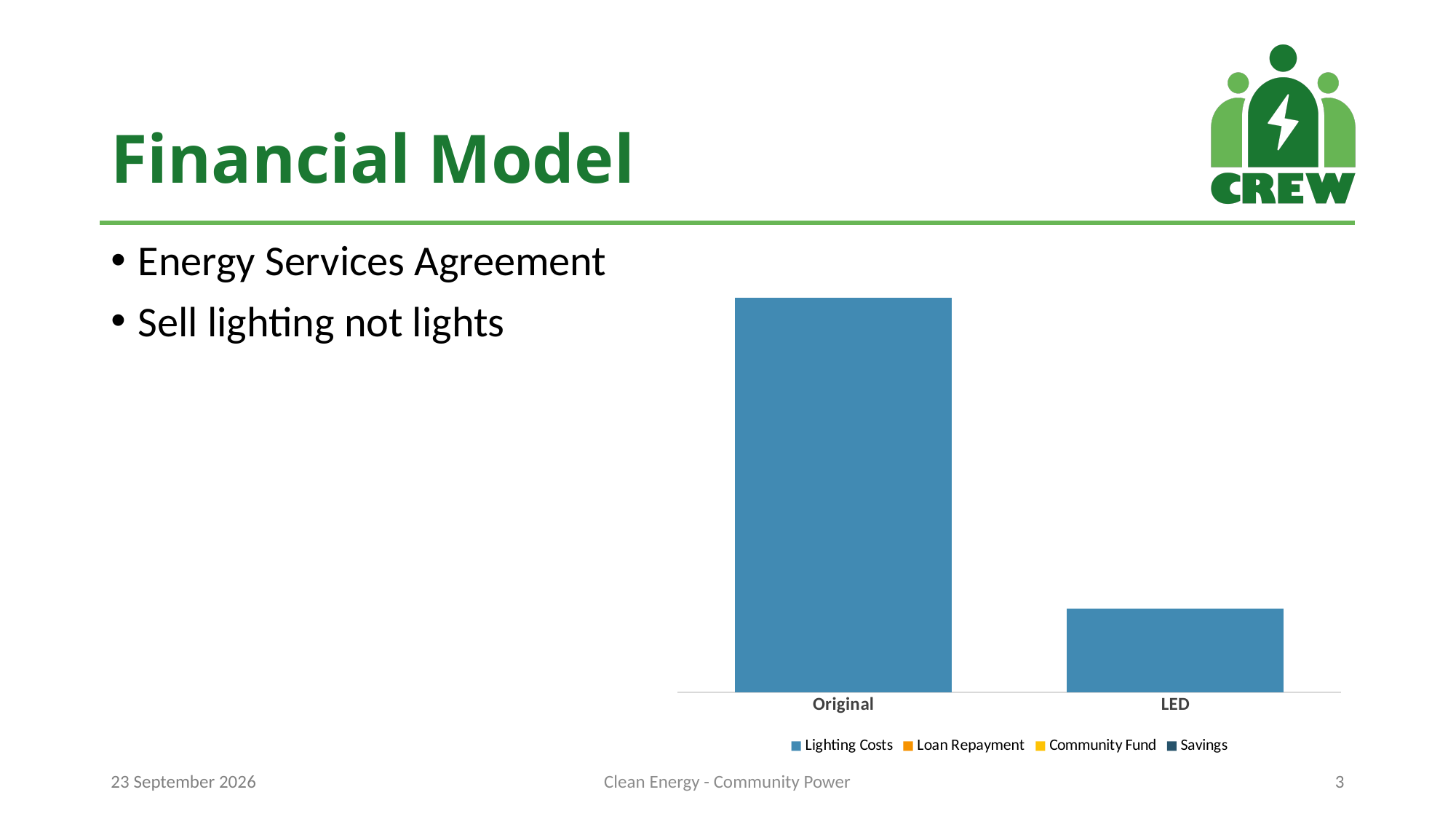
How many series does the chart's legend list? 4 What kind of chart is shown on the slide? bar chart Is the Lighting Costs bar for LED larger or smaller than the bar for Original? smaller How many categories are shown on the x axis of the chart? 2 What are the two categories labelled on the x axis of the chart? Original and LED Which category has the taller bar, Original or LED? Original Which series in the legend is shown in orange? Loan Repayment Which category has the highest Lighting Costs bar? Original Which category has the lowest Lighting Costs bar? LED